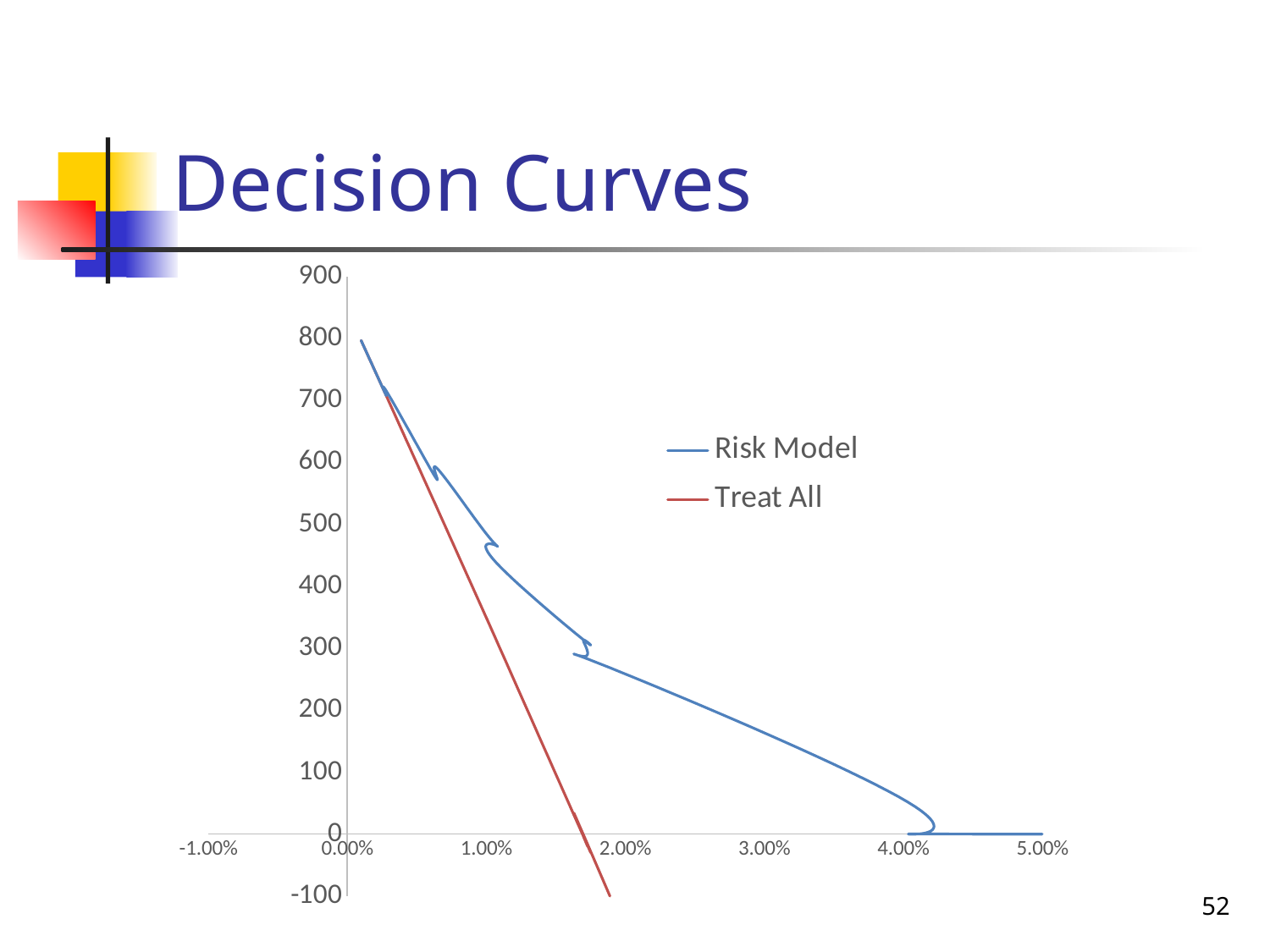
Do the values of the Treat All series rise or fall as the x axis increases? fall What is the title of the chart? Decision Curves At 1.00% on the x axis, which series has the larger value, Risk Model or Treat All? Risk Model What kind of chart is shown on the slide? line chart Which series drops below 0 on the y axis? Treat All Which series is drawn in red? Treat All How many series does the legend list? 2 Is the value of the Risk Model series at 3.00% greater or less than 300? less Is the value of the Risk Model series at 0.00% greater or less than 700? greater Do the values of the Risk Model series generally rise or fall as the x axis increases? fall Is the value of the Treat All series at 1.00% greater or less than 500? less